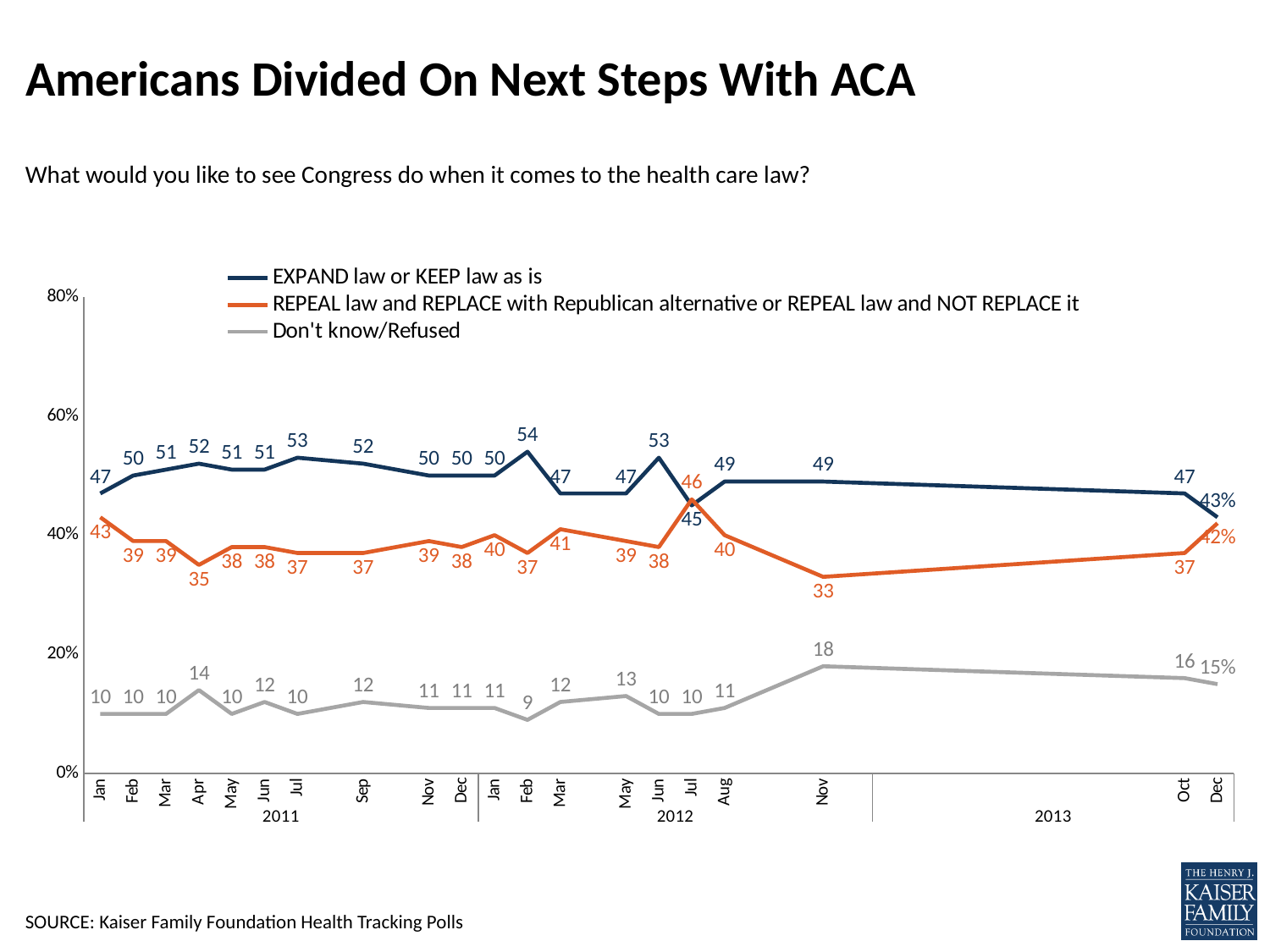
In which month is the 'Don't know/Refused' series at its highest? Nov 2012 What is the value for 'Don't know/Refused' in Nov 2012? 18 What kind of chart is shown on the slide? Line chart In which month is the REPEAL series at its lowest? Nov 2012 Does the 'Don't know/Refused' series rise or fall from Nov 2012 to Dec 2013? Fall In which month is the 'EXPAND law or KEEP law as is' series at its highest? Feb 2012 What is the value for 'REPEAL law and REPLACE with Republican alternative or REPEAL law and NOT REPLACE it' in Nov 2012? 33 In Dec 2013, what is the difference between the EXPAND/KEEP value and the REPEAL value? 1 percentage point In Jul 2012, which is larger: the EXPAND/KEEP value or the REPEAL value? REPEAL How many series does the legend list? 3 What is the value for the REPEAL series in Apr 2011? 35 What is the value for 'EXPAND law or KEEP law as is' in Dec 2013? 43%